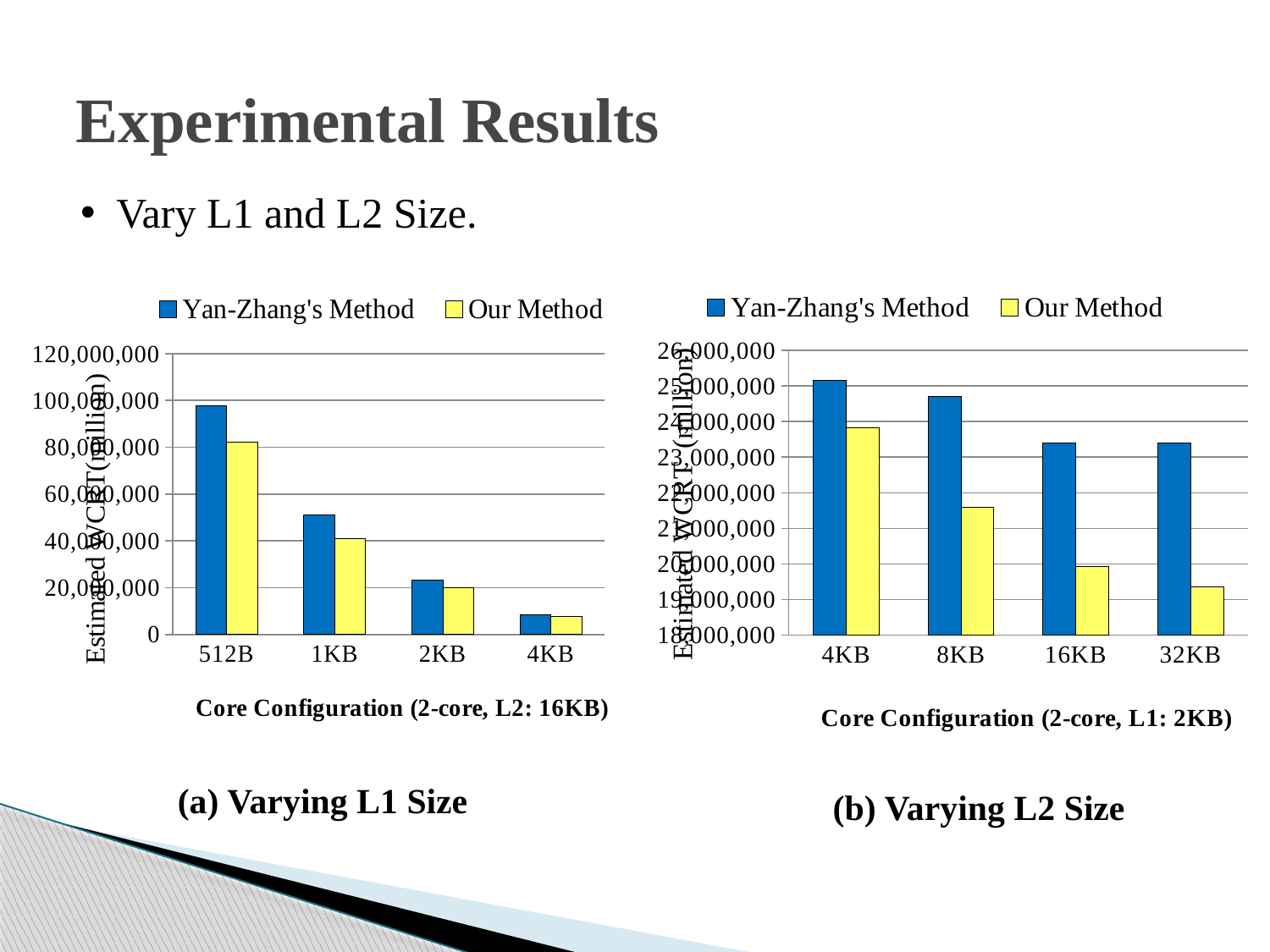
How many series does the legend of the right chart, (b) Varying L2 Size, list? 2 What is the x-axis title of the right chart, (b) Varying L2 Size? Core Configuration (2-core, L1: 2KB) How many core configuration categories are shown on the x axis of the left chart, (a) Varying L1 Size? 4 In the right chart, (b) Varying L2 Size, which L2 size has the highest estimated WCRT for Our Method? 4KB In the left chart, (a) Varying L1 Size, do the Yan-Zhang's Method values rise or fall as the L1 size increases from 512B to 4KB? fall In the right chart, (b) Varying L2 Size, which is larger at 8KB: Yan-Zhang's Method or Our Method? Yan-Zhang's Method In the left chart, (a) Varying L1 Size, is the value for Yan-Zhang's Method at 512B greater or less than 80,000,000? greater In the left chart, (a) Varying L1 Size, which L1 size has the lowest estimated WCRT for Our Method? 4KB In the right chart, (b) Varying L2 Size, is the value for Our Method at 32KB greater or less than 20,000,000? less In the left chart, (a) Varying L1 Size, which L1 size has the highest estimated WCRT for Yan-Zhang's Method? 512B In the left chart, (a) Varying L1 Size, is the value for Our Method at 1KB greater or less than 60,000,000? less What kind of chart is the left chart, (a) Varying L1 Size? bar chart